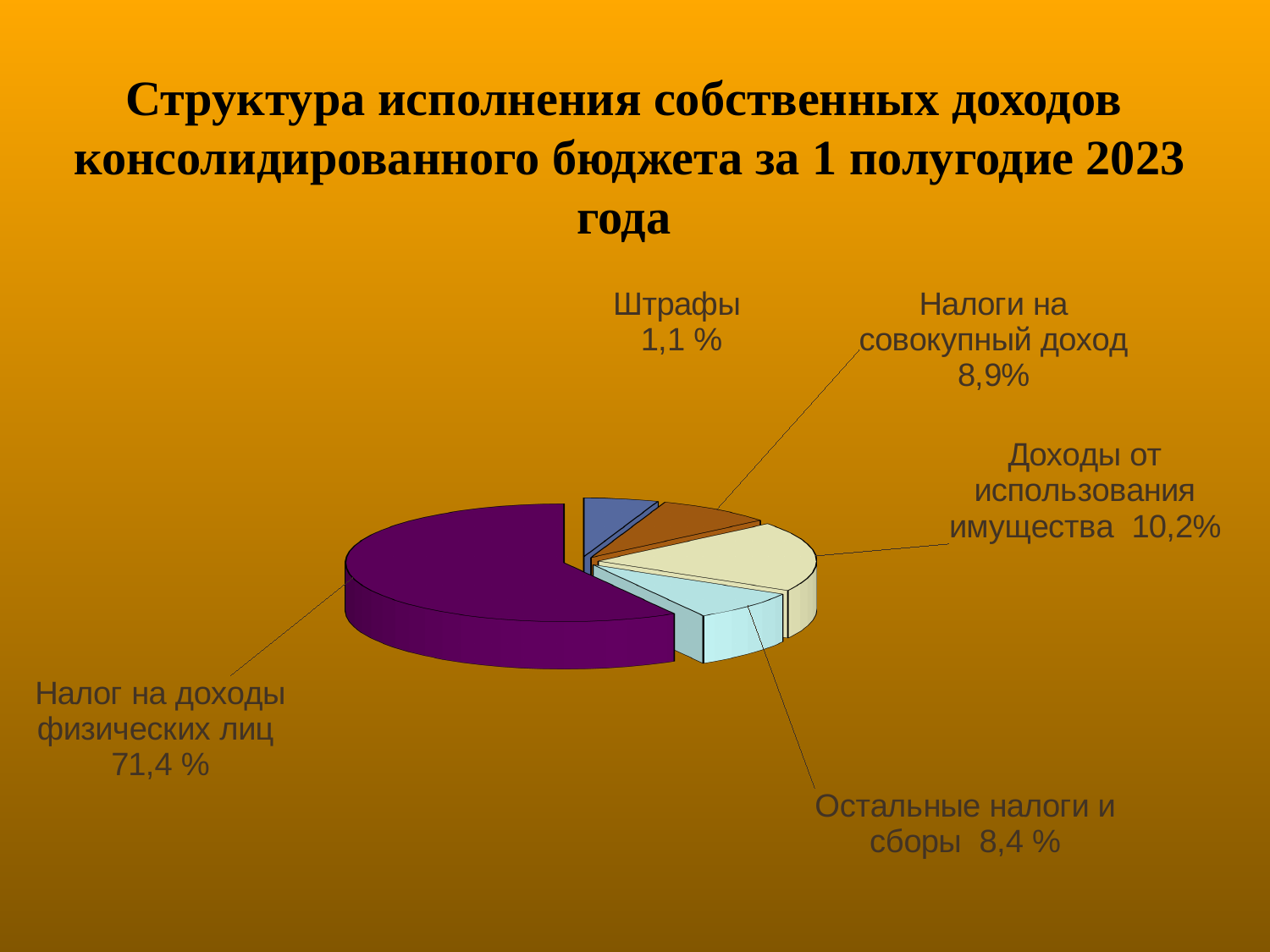
Which is larger: Налоги на совокупный доход or Остальные налоги и сборы? Налоги на совокупный доход Which category has the largest share of the pie? Налог на доходы физических лиц What value is shown for Штрафы? 1,1 % What type of chart is shown on the slide? Pie chart What value is shown for Налоги на совокупный доход? 8,9% How many slices does the pie chart have? 5 What value is shown for Остальные налоги и сборы? 8,4 % What is the title of the chart on the slide? Структура исполнения собственных доходов консолидированного бюджета за 1 полугодие 2023 года Which category has the smallest share of the pie? Штрафы What share of the pie is labelled for Налог на доходы физических лиц? 71,4 % What is the difference in percentage points between Доходы от использования имущества and Налоги на совокупный доход? 1,3 What value is shown for Доходы от использования имущества? 10,2%